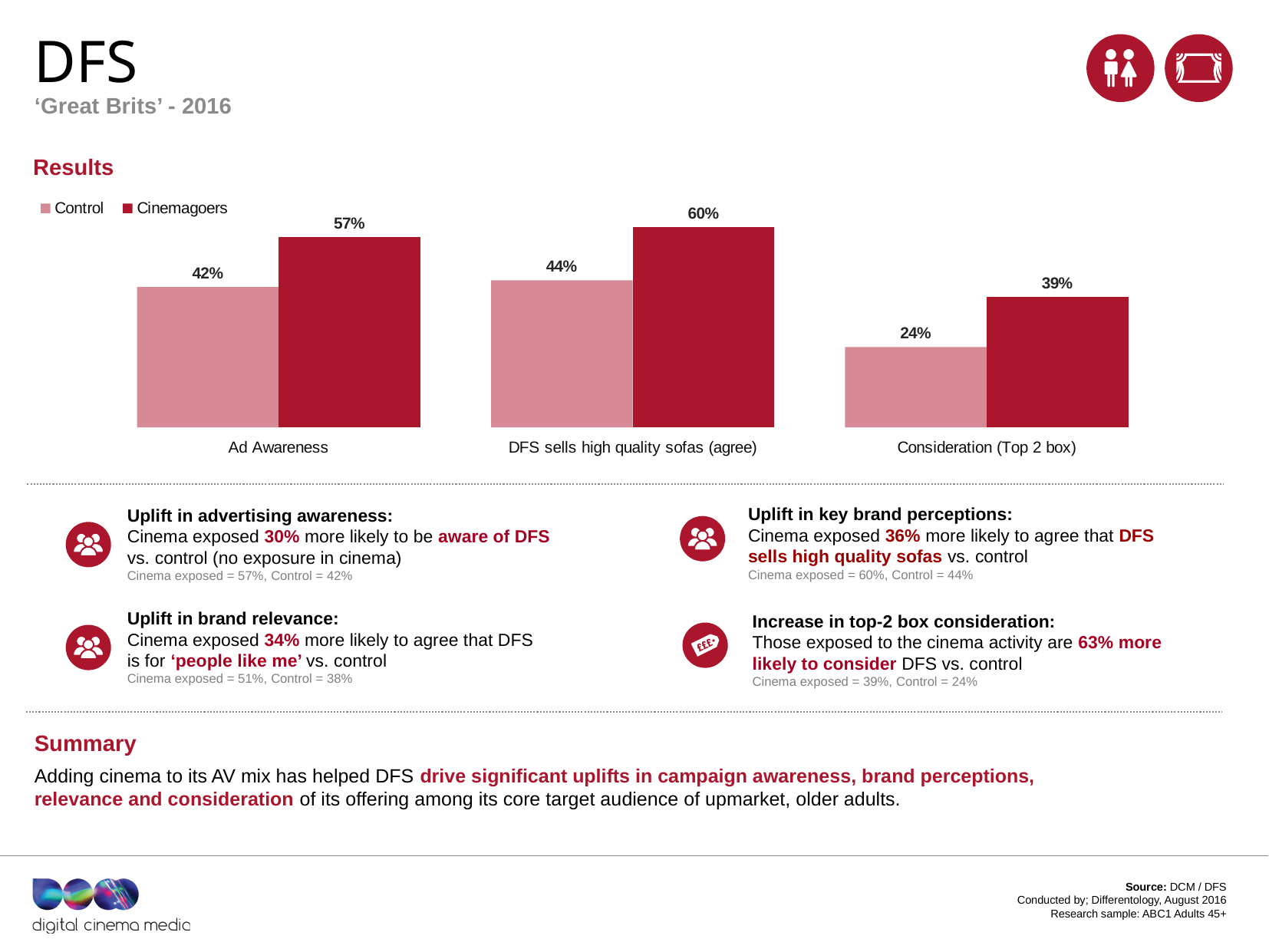
Which category has the highest Cinemagoers value? DFS sells high quality sofas (agree) How many series does the legend list? 2 Which is larger: the Cinemagoers value for Ad Awareness or the Cinemagoers value for 'DFS sells high quality sofas (agree)'? DFS sells high quality sofas (agree) How many categories are shown on the chart? 3 What is the Cinemagoers value for Ad Awareness? 57% What is the Control value for Consideration (Top 2 box)? 24% What is the Control value for 'DFS sells high quality sofas (agree)'? 44% Which series is shown in dark red in the legend? Cinemagoers What is the difference between the Cinemagoers and Control values for Ad Awareness? 15% What is the difference between the Cinemagoers and Control values for Consideration (Top 2 box)? 15% What kind of chart is shown on the slide? Bar chart Which category has the lowest Control value? Consideration (Top 2 box)